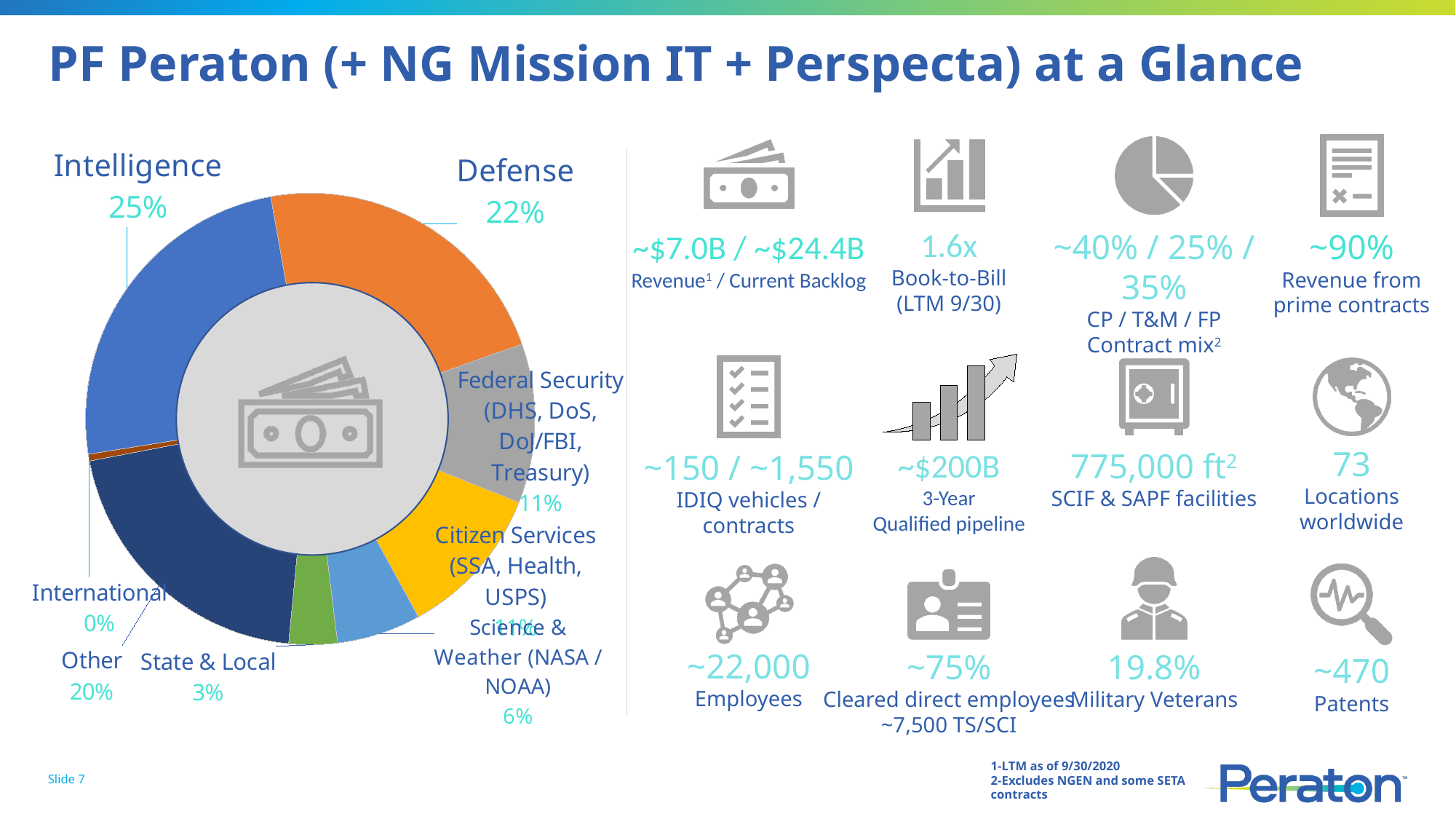
Which category has the largest share of the pie chart? Intelligence Which category has the smallest share of the pie chart? International What share of the pie chart does Intelligence represent? 25% What percentage is shown for Federal Security (DHS, DoS, DoJ/FBI, Treasury)? 11% What percentage is shown for State & Local in the pie chart? 3% Which is larger in the pie chart, Other or Defense? Defense How many categories are labelled in the pie chart? 8 How many percentage points larger is Intelligence than Defense in the pie chart? 3 What percentage is shown for Science & Weather (NASA / NOAA)? 6% What is the value shown for Defense in the pie chart? 22% What kind of chart is shown on the left of the slide? Pie chart What percentage is shown for Other in the pie chart? 20%